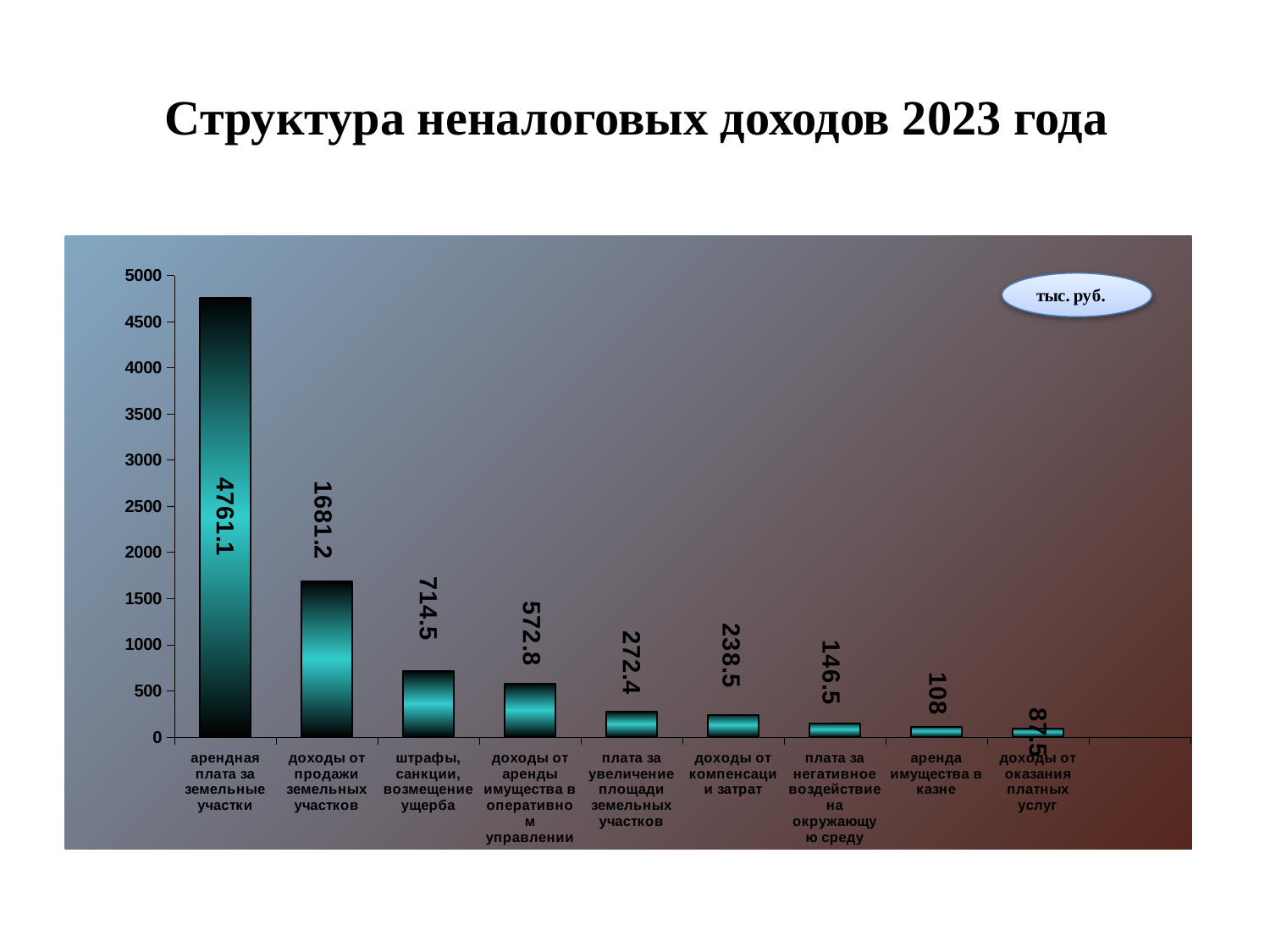
На сколько значение «арендная плата за земельные участки» больше значения «доходы от продажи земельных участков»? 3079.9 Какое значение показано для категории «аренда имущества в казне»? 108 Какая категория имеет наибольшее значение на диаграмме? арендная плата за земельные участки Сколько категорий показано на диаграмме? 9 Что больше: «плата за увеличение площади земельных участков» или «доходы от компенсации затрат»? плата за увеличение площади земельных участков В каких единицах измерения приведены значения на диаграмме? тыс. руб. Какое значение показано для категории «доходы от продажи земельных участков»? 1681.2 На сколько значение «штрафы, санкции, возмещение ущерба» больше значения «доходы от аренды имущества в оперативном управлении»? 141.7 Какое значение показано для категории «штрафы, санкции, возмещение ущерба»? 714.5 Какого типа эта диаграмма? столбчатая (bar chart) Какая категория имеет наименьшее значение на диаграмме? доходы от оказания платных услуг Какое значение показано для категории «арендная плата за земельные участки»? 4761.1